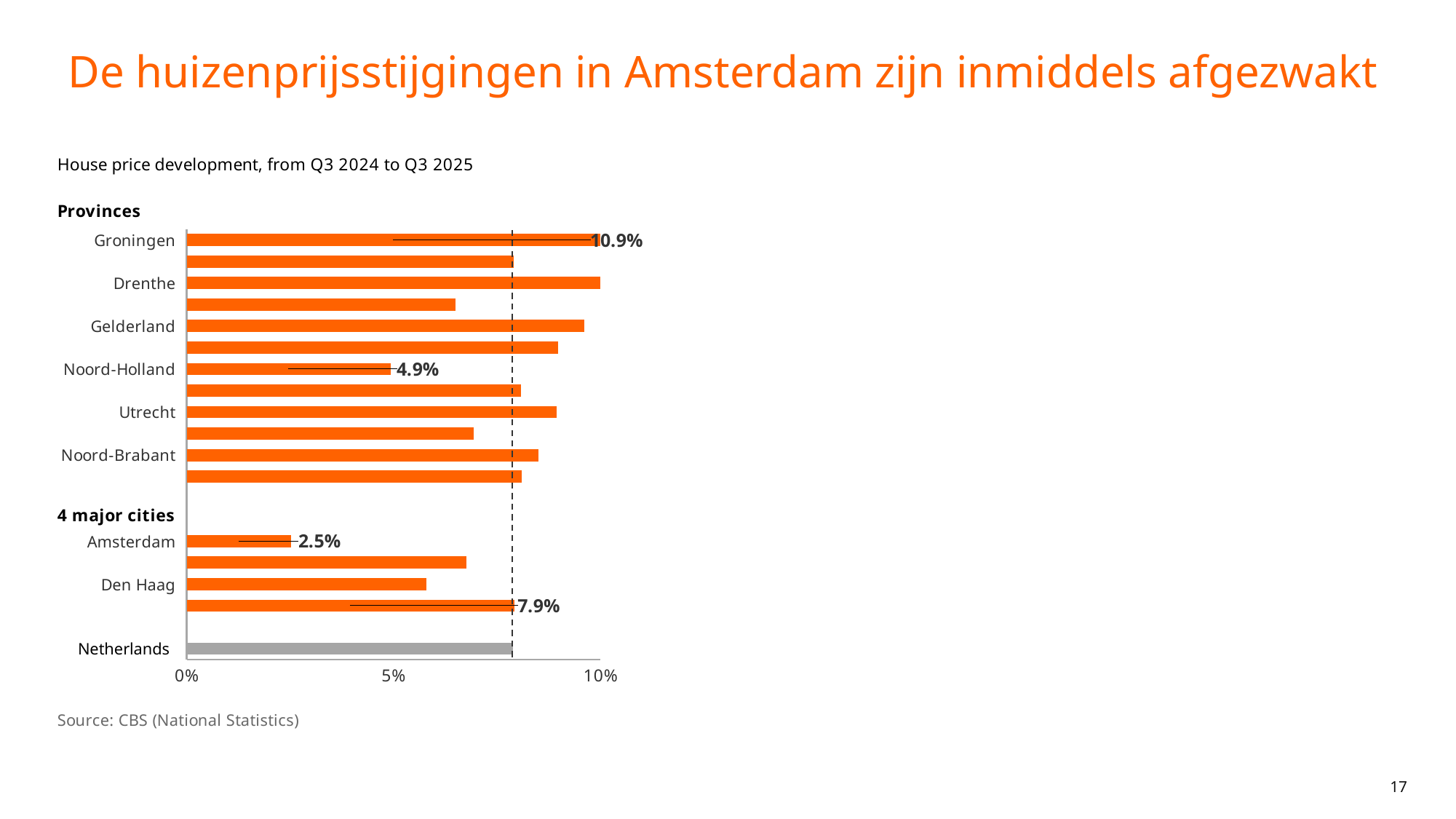
What kind of chart is shown on the slide? bar chart What is the difference between the labelled values for Groningen and Amsterdam? 8.4 percentage points What colour is the bar for Netherlands? grey Which labelled category has the longest bar in the chart? Groningen Is the value for Den Haag greater or less than 5%? greater Is the value for Utrecht greater or less than 10%? less What is the house price development value shown for Noord-Holland? 4.9% Which labelled category has the shortest bar in the chart? Amsterdam What is the house price development value shown for Groningen? 10.9% What is the difference between the labelled values for Noord-Holland and Amsterdam? 2.4 percentage points Which is larger, the value for Noord-Holland or the value for Amsterdam? Noord-Holland What is the house price development value shown for Amsterdam? 2.5%